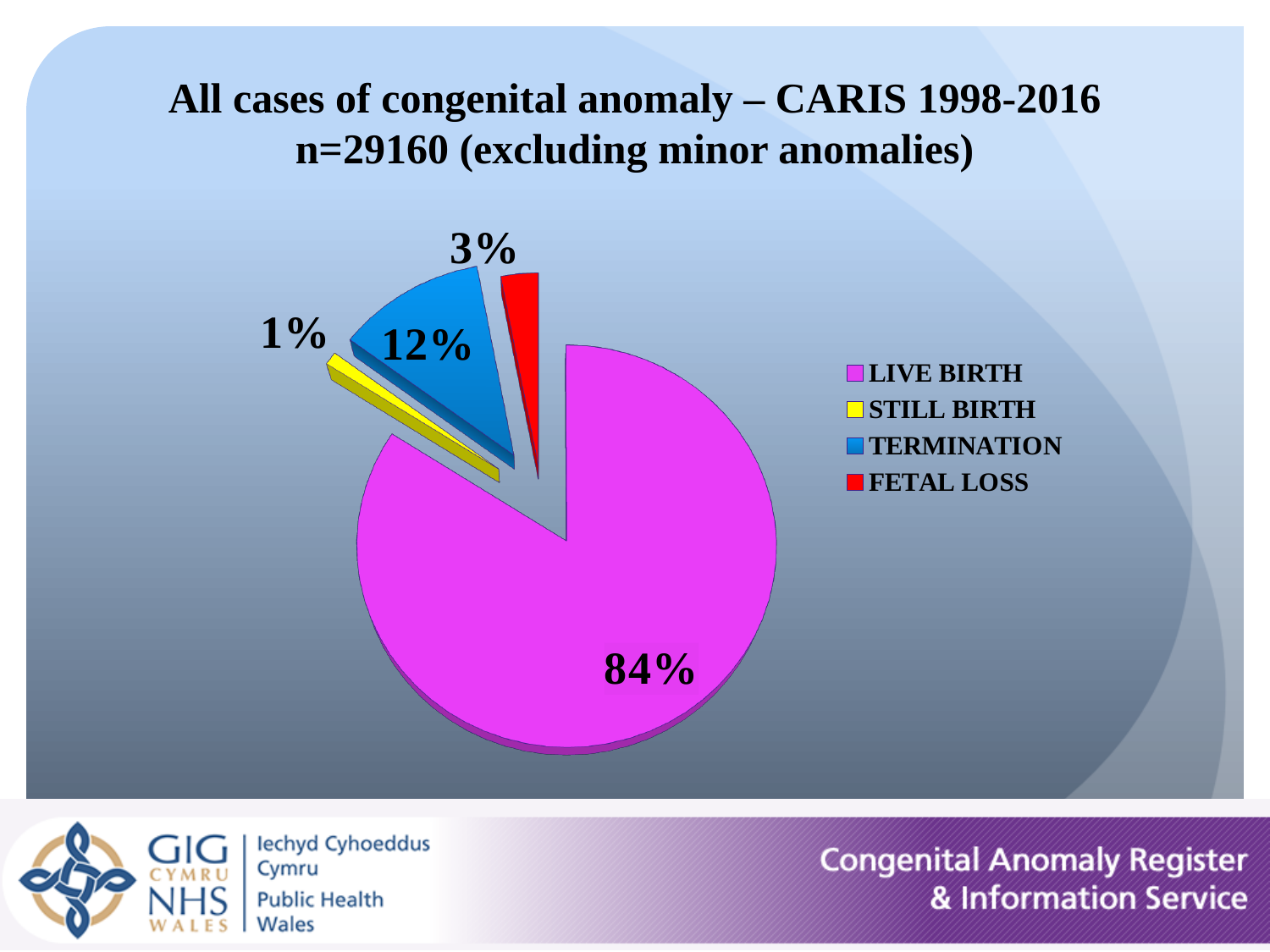
What is the total number of cases (n) stated in the chart title? 29160 What percentage of cases are terminations? 12% How many categories does the pie chart show? 4 What percentage of cases are fetal losses? 3% What is the difference in percentage points between live births and terminations? 72 What colour is the slice representing termination? Blue Which outcome category has the smallest share of the pie? STILL BIRTH What kind of chart is shown on the slide? Pie chart What percentage of cases are live births? 84% Which outcome category has the largest share of the pie? LIVE BIRTH What percentage of cases are still births? 1% Which is larger, the share for termination or the share for fetal loss? TERMINATION